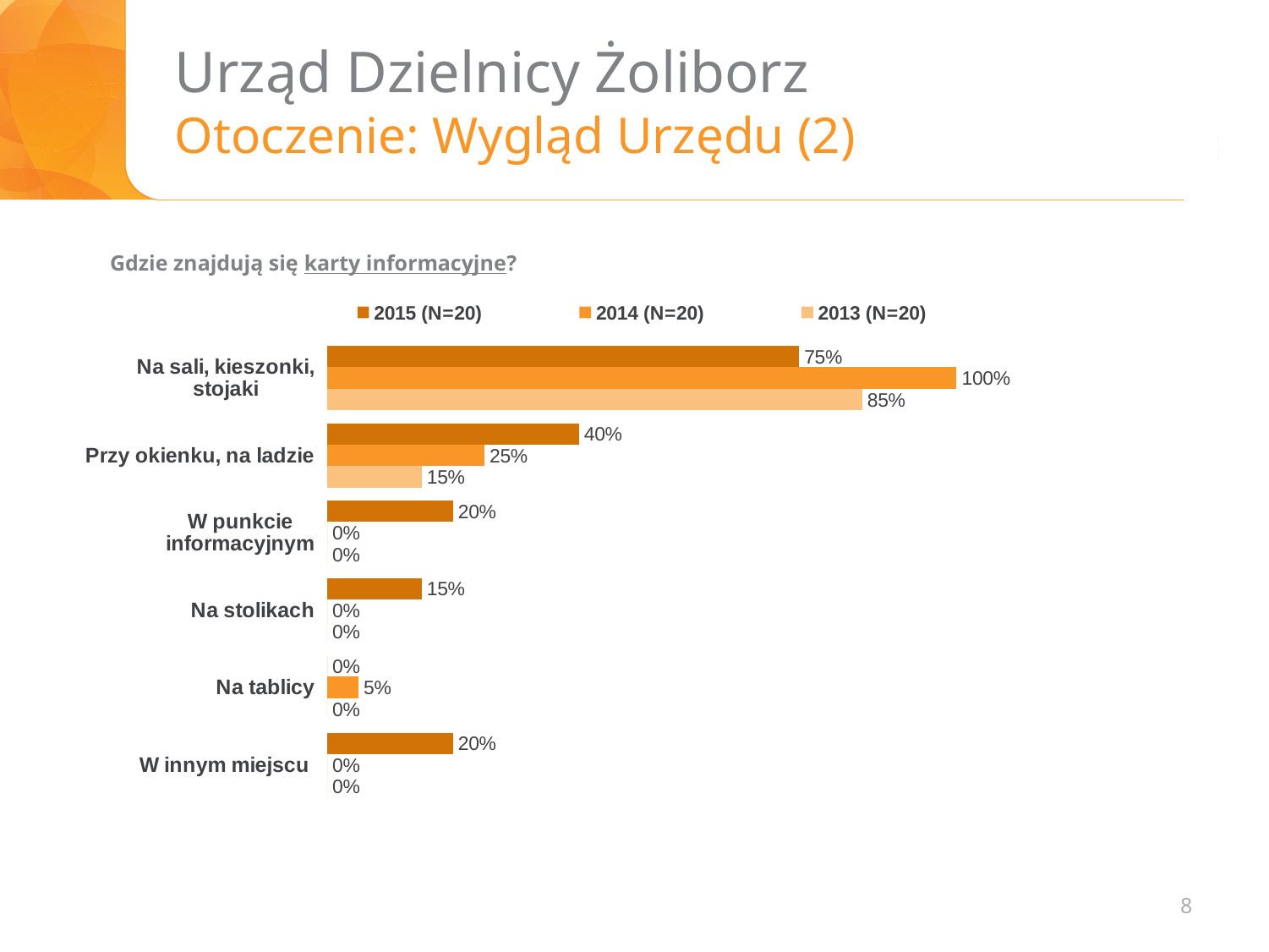
What is the difference between the 2014 (N=20) and 2013 (N=20) values for 'Na sali, kieszonki, stojaki'? 15% What is the difference between the 2015 (N=20) and 2014 (N=20) values for 'Przy okienku, na ladzie'? 15% Which is larger for 'Na sali, kieszonki, stojaki': the 2015 (N=20) value or the 2013 (N=20) value? 2013 (N=20) Which category has the lowest value in the 2015 (N=20) series? Na tablicy What is the value for 'Na sali, kieszonki, stojaki' in the 2014 (N=20) series? 100% How many series does the legend list? 3 What kind of chart is shown on the slide? Bar chart Which category has the highest value in the 2015 (N=20) series? Na sali, kieszonki, stojaki What is the value for 'W punkcie informacyjnym' in the 2013 (N=20) series? 0% What is the value for 'Przy okienku, na ladzie' in the 2015 (N=20) series? 40% How many categories are shown on the chart? 6 What is the value for 'Na tablicy' in the 2014 (N=20) series? 5%